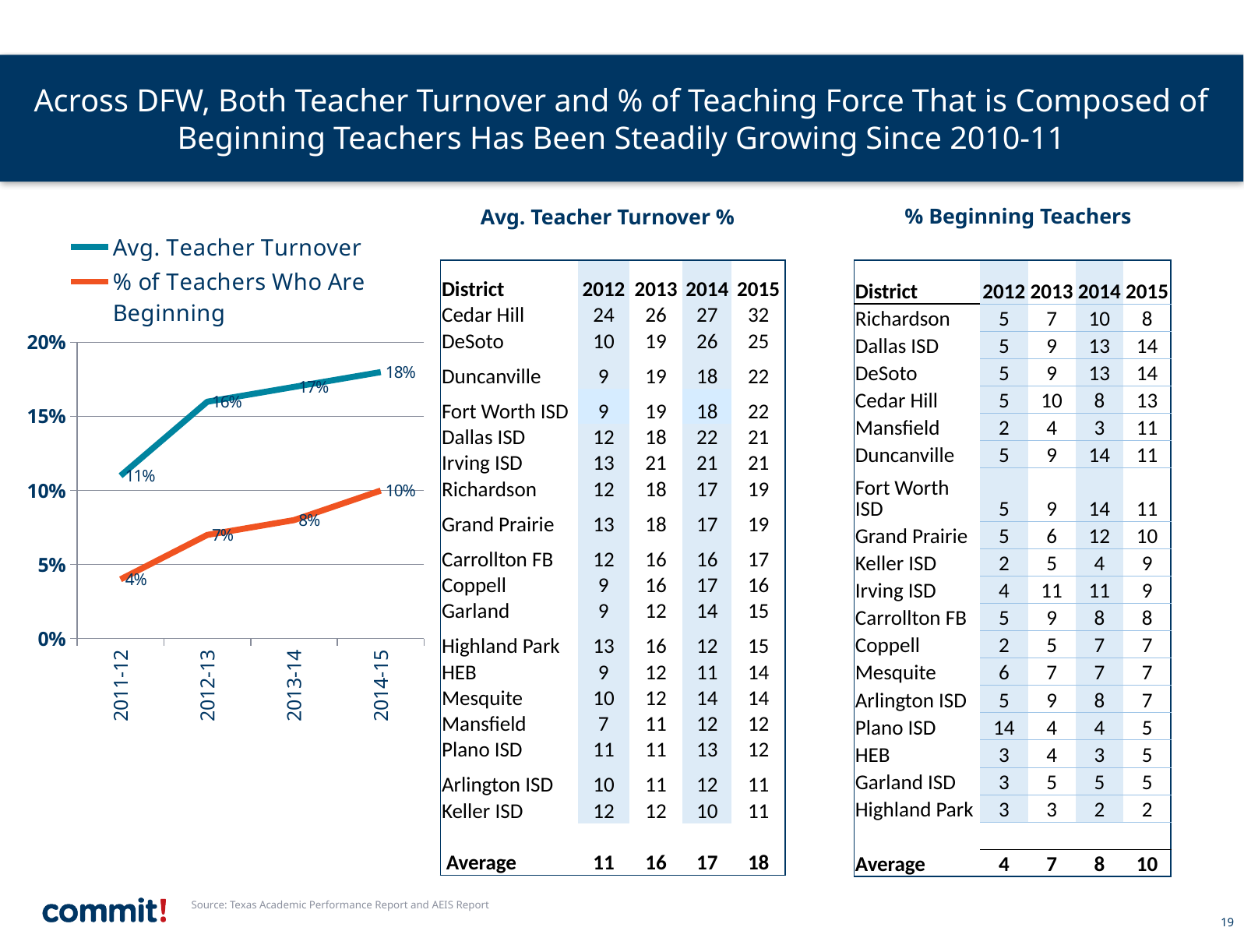
In which school year is % of Teachers Who Are Beginning highest? 2014-15 What is the % of Teachers Who Are Beginning value for 2012-13? 7% Which series is drawn in orange on the chart? % of Teachers Who Are Beginning What type of chart is shown on the slide? Line chart What is the difference between Avg. Teacher Turnover in 2014-15 and in 2011-12? 7% Does the % of Teachers Who Are Beginning series rise or fall from 2011-12 to 2014-15? Rise How many series does the chart legend list? 2 In which school year is Avg. Teacher Turnover lowest? 2011-12 What is the Avg. Teacher Turnover value for 2014-15? 18% What is the Avg. Teacher Turnover value for 2011-12? 11% How many school years are plotted along the x axis of the chart? 4 What is the % of Teachers Who Are Beginning value for 2014-15? 10%